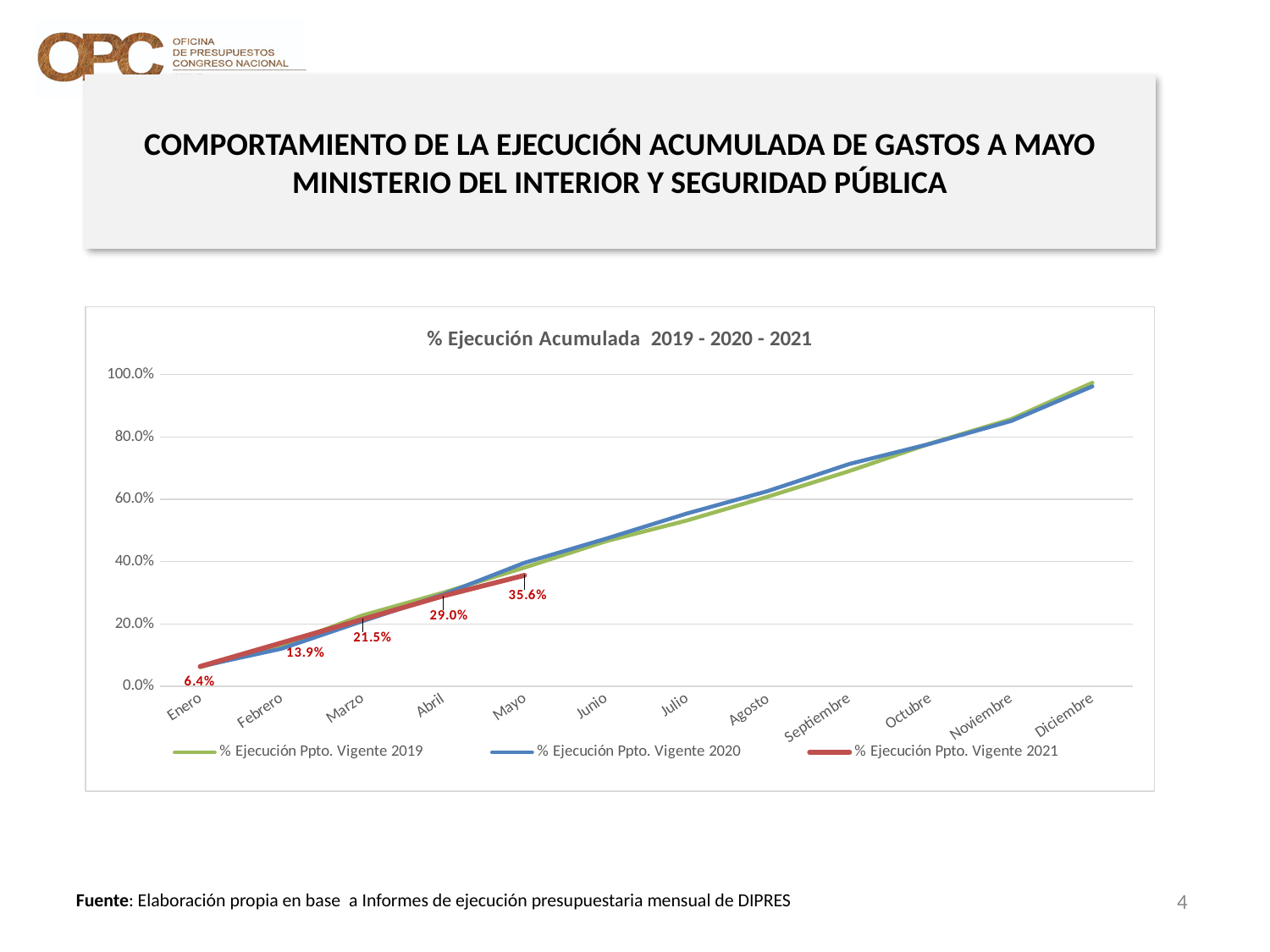
What is the value of % Ejecución Ppto. Vigente 2021 for Mayo? 35.6% What is the title of the chart? % Ejecución Acumulada 2019 - 2020 - 2021 What kind of chart is shown on the slide? Line chart Is the value for % Ejecución Ppto. Vigente 2020 in Diciembre greater or less than 80.0%? greater What is the value of % Ejecución Ppto. Vigente 2021 for Abril? 29.0% What is the value of % Ejecución Ppto. Vigente 2021 for Enero? 6.4% What is the value of % Ejecución Ppto. Vigente 2021 for Marzo? 21.5% Do the values for % Ejecución Ppto. Vigente 2019 rise or fall from Enero to Diciembre? Rise Which month has the highest value for % Ejecución Ppto. Vigente 2021? Mayo By how many percentage points did % Ejecución Ppto. Vigente 2021 increase from Enero to Mayo? 29.2 How many months are shown on the x axis of the chart? 12 How many series does the legend list? 3